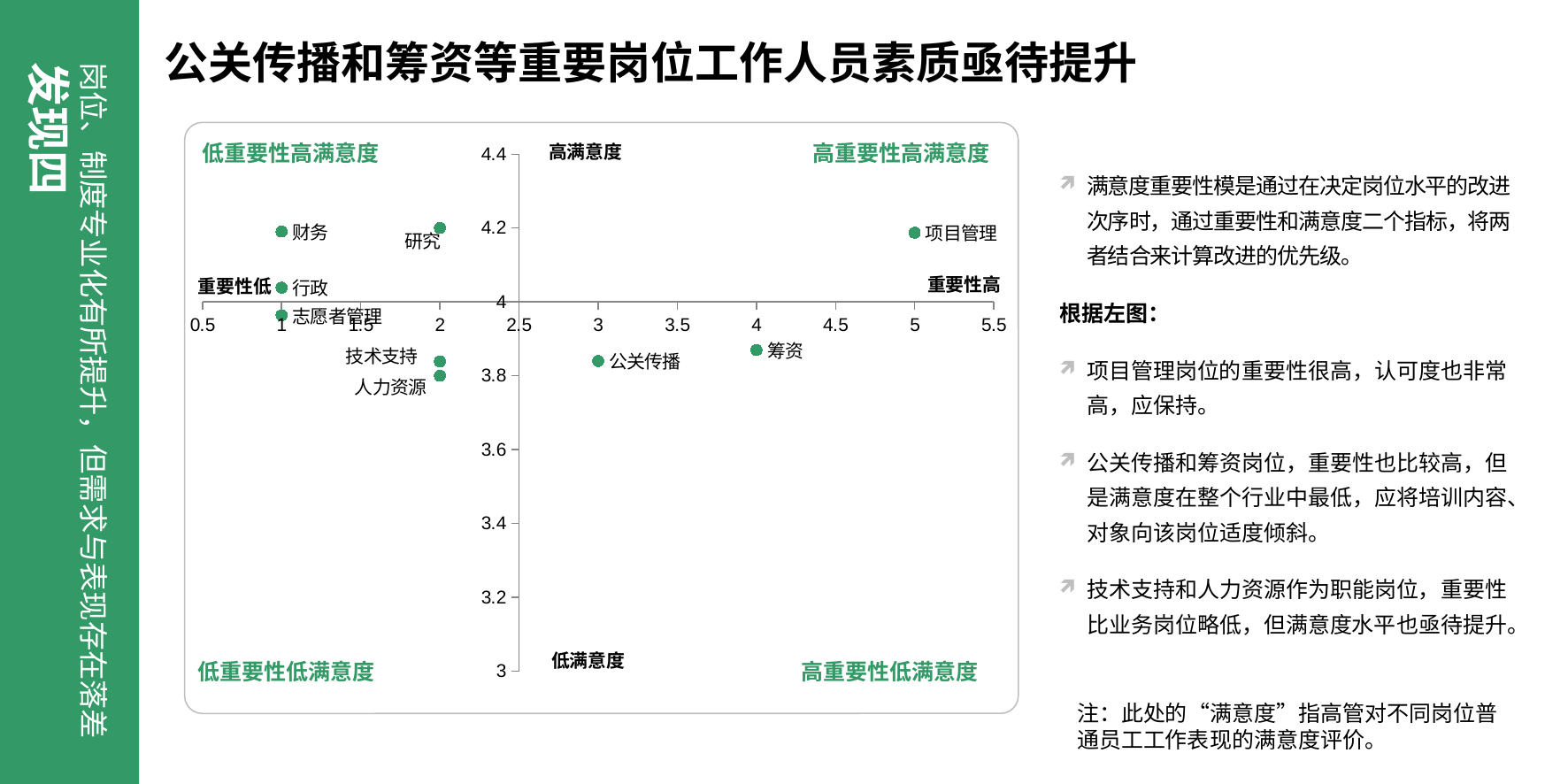
Is the importance (x-axis) value for 项目管理 greater or less than 4.5? greater What kind of chart is shown on the slide? scatter chart What is the importance (x-axis) value for 公关传播? 3 What label is shown in the top-right quadrant of the chart? 高重要性高满意度 Is the satisfaction (y-axis) value for 财务 greater or less than 4? greater What label is shown in the bottom-left quadrant of the chart? 低重要性低满意度 Which has the higher importance (x-axis value), 筹资 or 公关传播? 筹资 Is the satisfaction (y-axis) value for 公关传播 greater or less than 4? less Which has the higher satisfaction (y-axis value), 财务 or 人力资源? 财务 How many positions (data points) are plotted in the chart? 9 Which position has the highest importance (x-axis value) in the chart? 项目管理